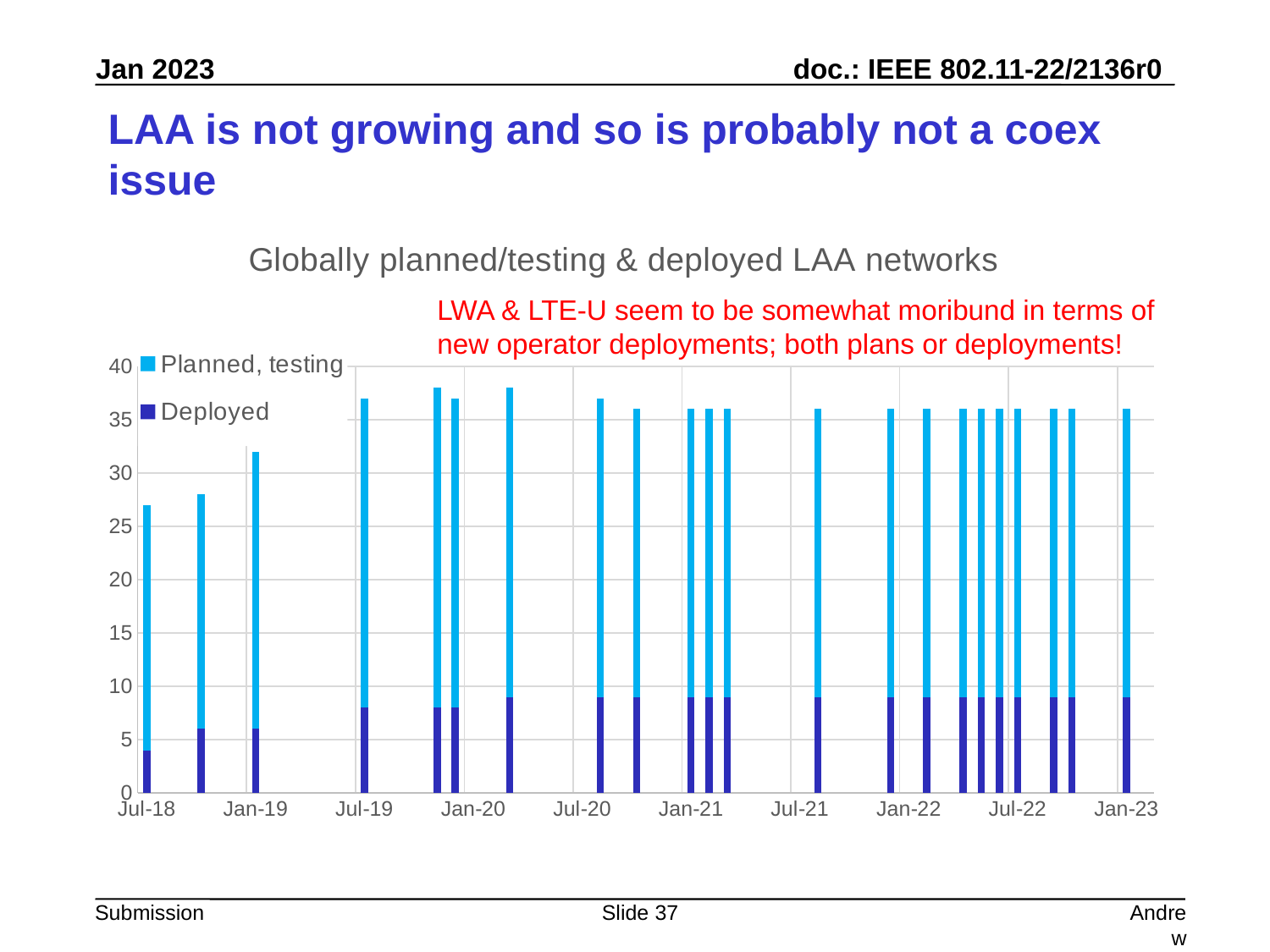
Which bar is taller in total, the one at Jul-18 or the one at Jan-23? Jan-23 Is the Deployed portion of the bar at Jul-18 greater or less than 5? less Is the total height of the bar at Jul-18 greater or less than 30? less What kind of chart is shown on the slide? stacked bar chart Do the total bar heights rise or fall from Jul-18 to Jan-23? rise What is the title of the chart? Globally planned/testing & deployed LAA networks How many series does the chart legend list? 2 Is the total height of the bar at Jan-23 greater or less than 30? greater How many date labels are shown on the x axis? 10 What are the two series named in the legend? Planned, testing; Deployed